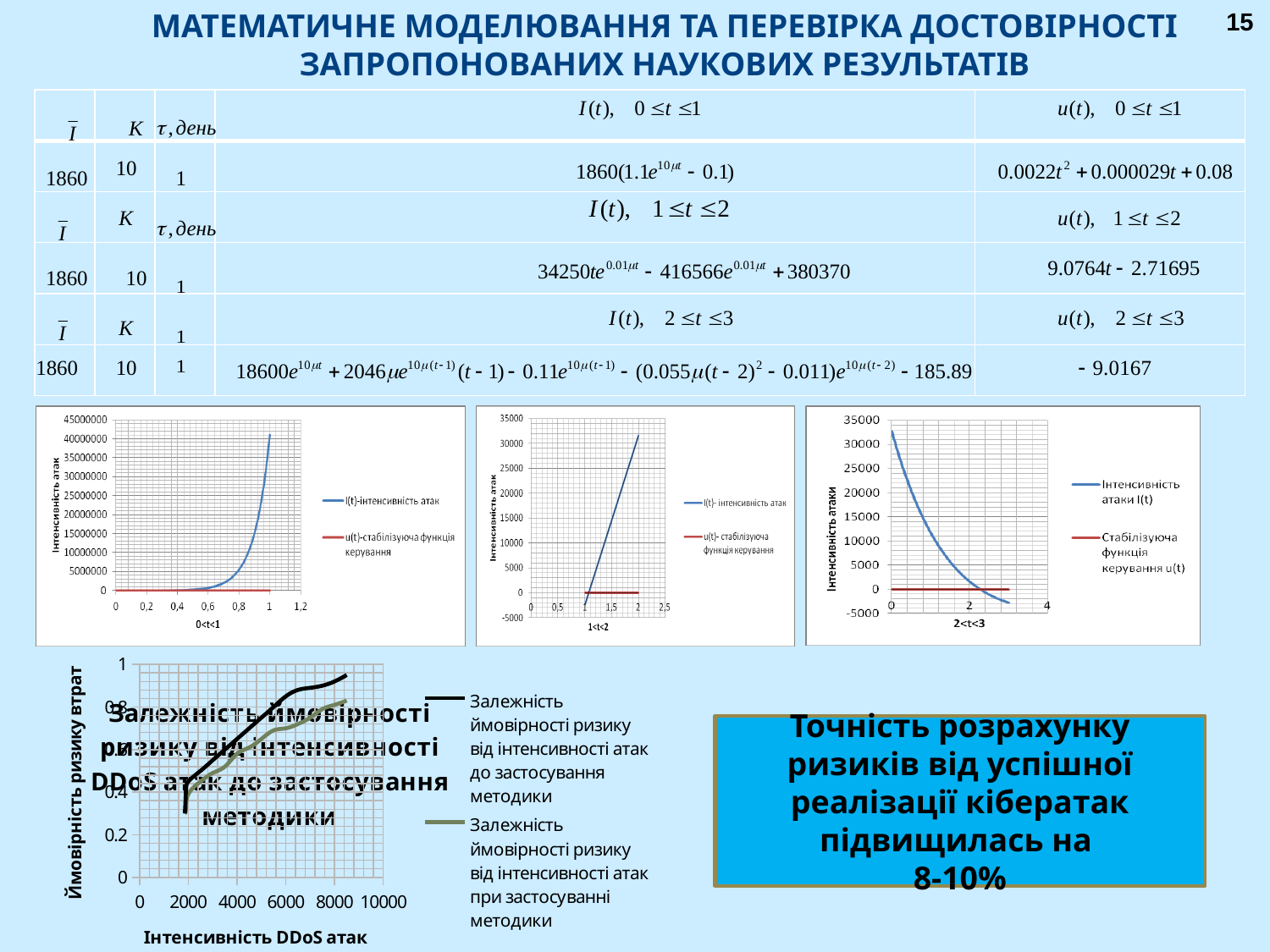
In the chart labelled 2<t<3, what is the second legend entry? Стабілізуюча функція керування u(t) In the bottom-left chart, at a DDoS intensity of 6000, which series has the higher risk probability: before applying the methodology (до застосування методики) or after applying it (при застосуванні методики)? before applying the methodology (до застосування методики) In the chart labelled 2<t<3, does the I(t) line rise or fall as t increases from 2 to 3? falls In the chart labelled 0<t<1, is the value of I(t) at t=1 greater or less than 35000000? greater In the chart labelled 0<t<1, how many series does the legend list? 2 In the chart labelled 0<t<1, does the I(t) line rise or fall as t increases from 0 to 1? rises In the bottom-left chart, how many series does the legend list? 2 In the chart labelled 1<t<2, is the value of I(t) at t=2 greater or less than 25000? greater In the bottom-left chart, what is the title of the x axis? Інтенсивність DDoS атак What kind of chart is the chart labelled 0<t<1 on the left of the middle row? line chart In the chart labelled 1<t<2, does the I(t) line rise or fall as t increases from 1 to 2? rises In the chart labelled 2<t<3, is the value of I(t) at t=2 greater or less than 30000? greater